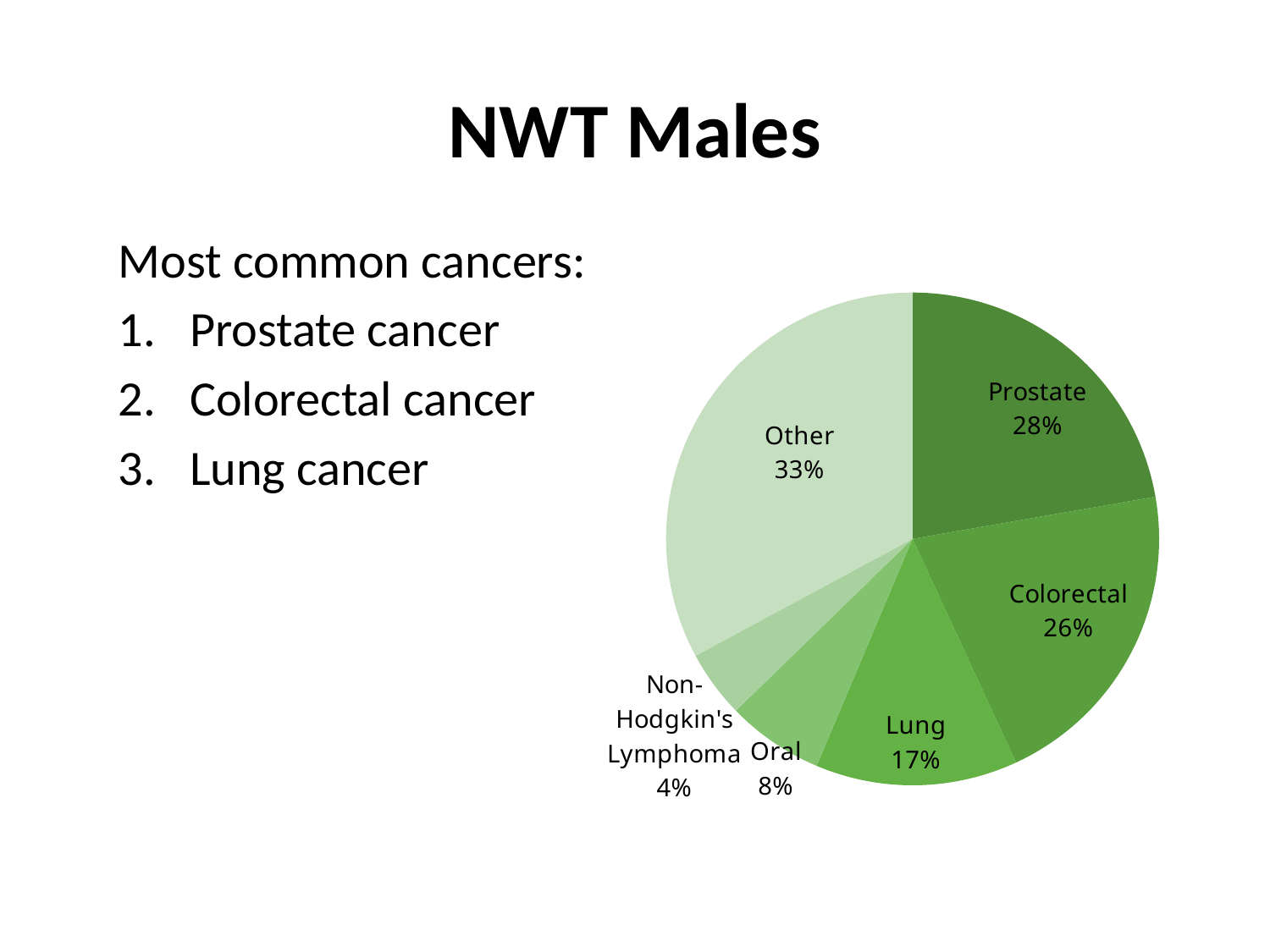
Which slice of the pie is the smallest? Non-Hodgkin's Lymphoma What share of the pie does Prostate represent? 28% What kind of chart is shown on the slide? pie chart What is the value shown for Oral? 8% What is the value shown for Lung? 17% What is the value shown for Colorectal? 26% What is the value shown for Non-Hodgkin's Lymphoma? 4% Which is larger, the Lung slice or the Oral slice? Lung How many slices does the pie chart have? 6 What is the difference between the Prostate and Lung shares? 11% What is the title of the slide containing the pie chart? NWT Males Which slice of the pie is the largest? Other